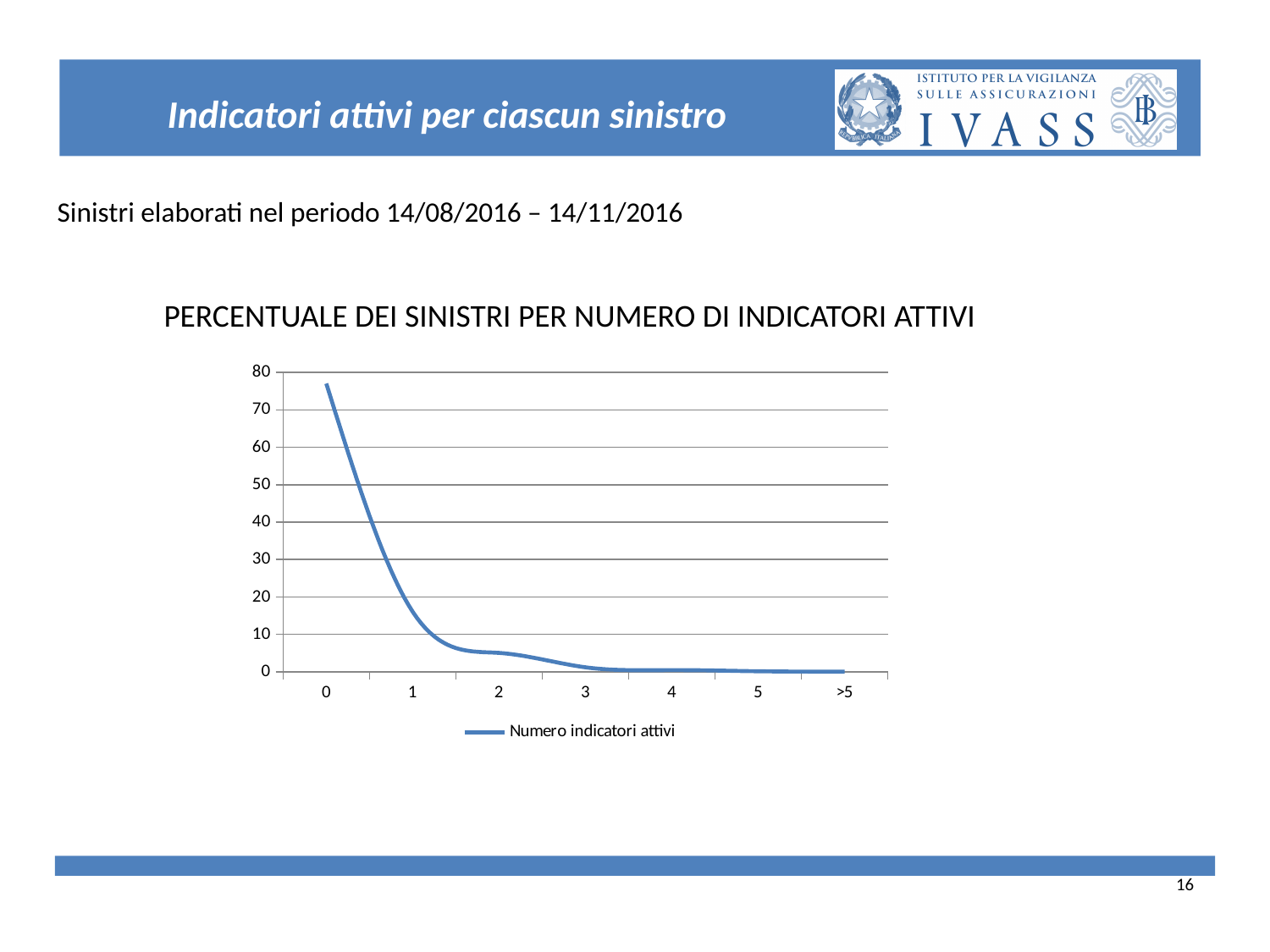
What is the title of the chart? PERCENTUALE DEI SINISTRI PER NUMERO DI INDICATORI ATTIVI Is the value for category 2 greater or less than 10? less Which category has the highest value in the chart? 0 Do the values rise or fall as you move from 0 to >5 along the x axis? fall Which has the larger value, category 0 or category 1? 0 How many categories are shown on the x axis of the chart? 7 What kind of chart is shown on the slide? line chart How many series does the legend list? 1 Is the value for category 1 greater or less than 20? less What is the name of the series shown in the legend? Numero indicatori attivi Is the value for category 0 greater or less than 70? greater